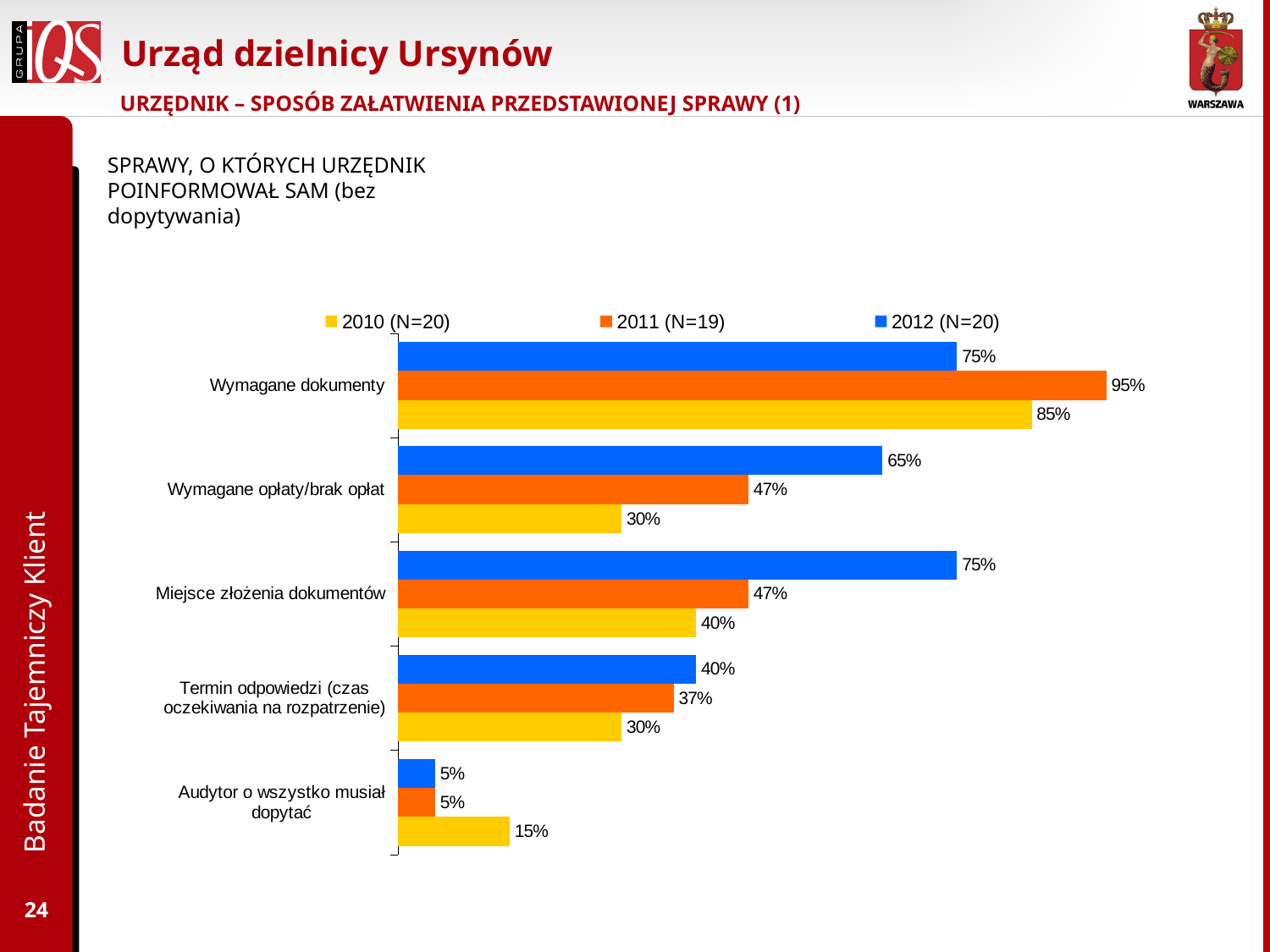
What is the difference between the 2011 (N=19) and 2010 (N=20) values for "Wymagane dokumenty"? 10% What is the value for "Audytor o wszystko musiał dopytać" in the 2010 (N=20) series? 15% Which category has the highest value in the 2012 (N=20) series? Wymagane dokumenty and Miejsce złożenia dokumentów (both 75%) What is the value for "Wymagane dokumenty" in the 2011 (N=19) series? 95% Which colour represents the 2011 (N=19) series? Orange What kind of chart is shown on the slide? Bar chart How many series does the legend list? 3 What is the difference between the 2012 (N=20) and 2010 (N=20) values for "Miejsce złożenia dokumentów"? 35% Which is larger for "Termin odpowiedzi (czas oczekiwania na rozpatrzenie)": the 2012 (N=20) value or the 2011 (N=19) value? 2012 (N=20) What is the value for "Wymagane opłaty/brak opłat" in the 2012 (N=20) series? 65% Which category has the lowest value in the 2011 (N=19) series? Audytor o wszystko musiał dopytać How many categories are shown on the chart? 5